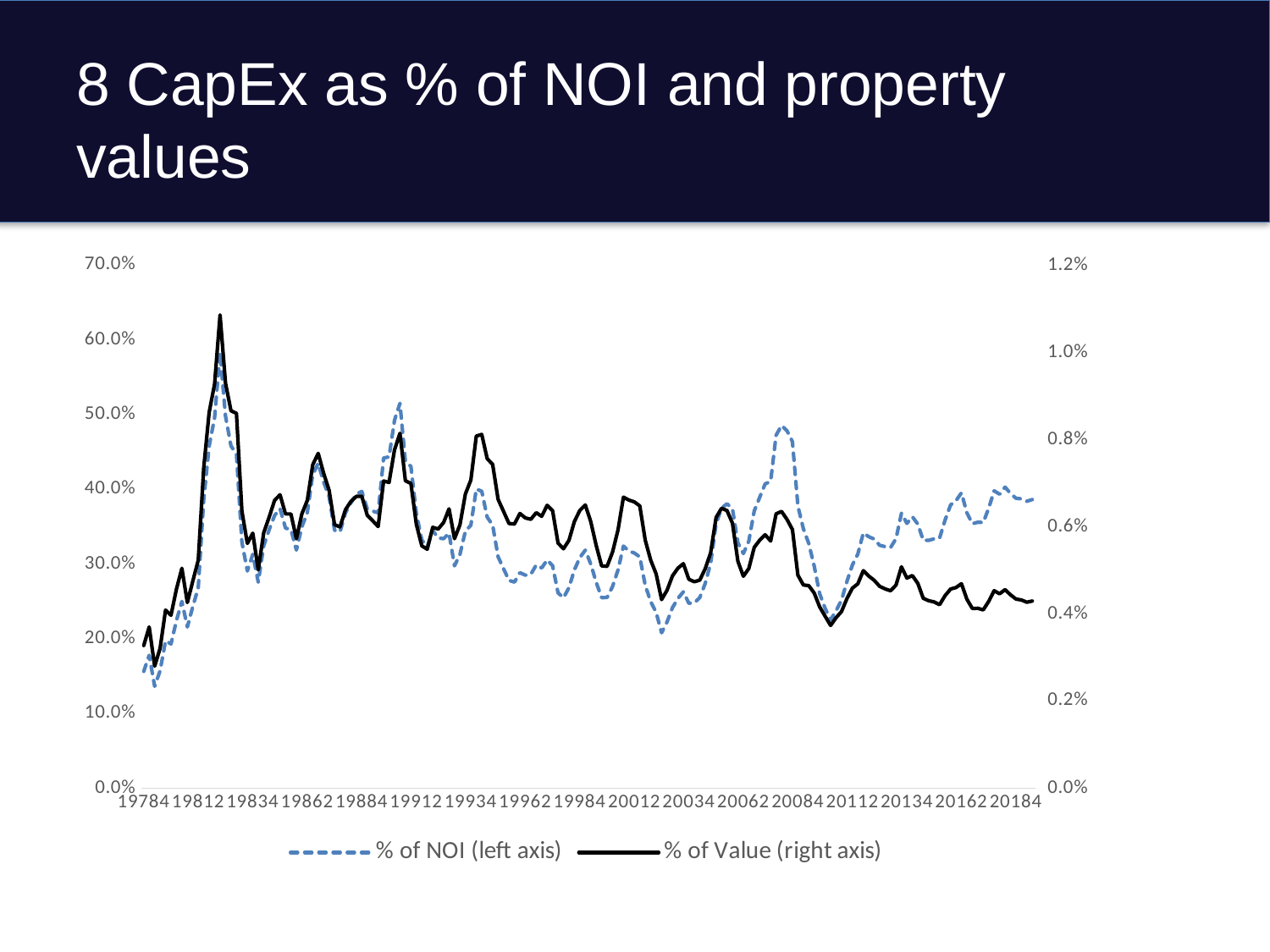
What is the maximum value shown on the left axis? 70.0% Is the value for % of NOI at 19784 greater or less than 20.0%? less Which series is drawn with a dashed line? % of NOI (left axis) What kind of chart is shown on the slide? Line chart How many series does the legend list? 2 Is the highest value reached by % of Value greater or less than 1.0%? greater Which series is plotted against the right axis? % of Value Is the value for % of Value at 20184 greater or less than 0.6%? less Does the % of NOI series rise or fall between 20112 and 20184? rise Does the % of Value series rise or fall overall between 19834 and 20184? fall